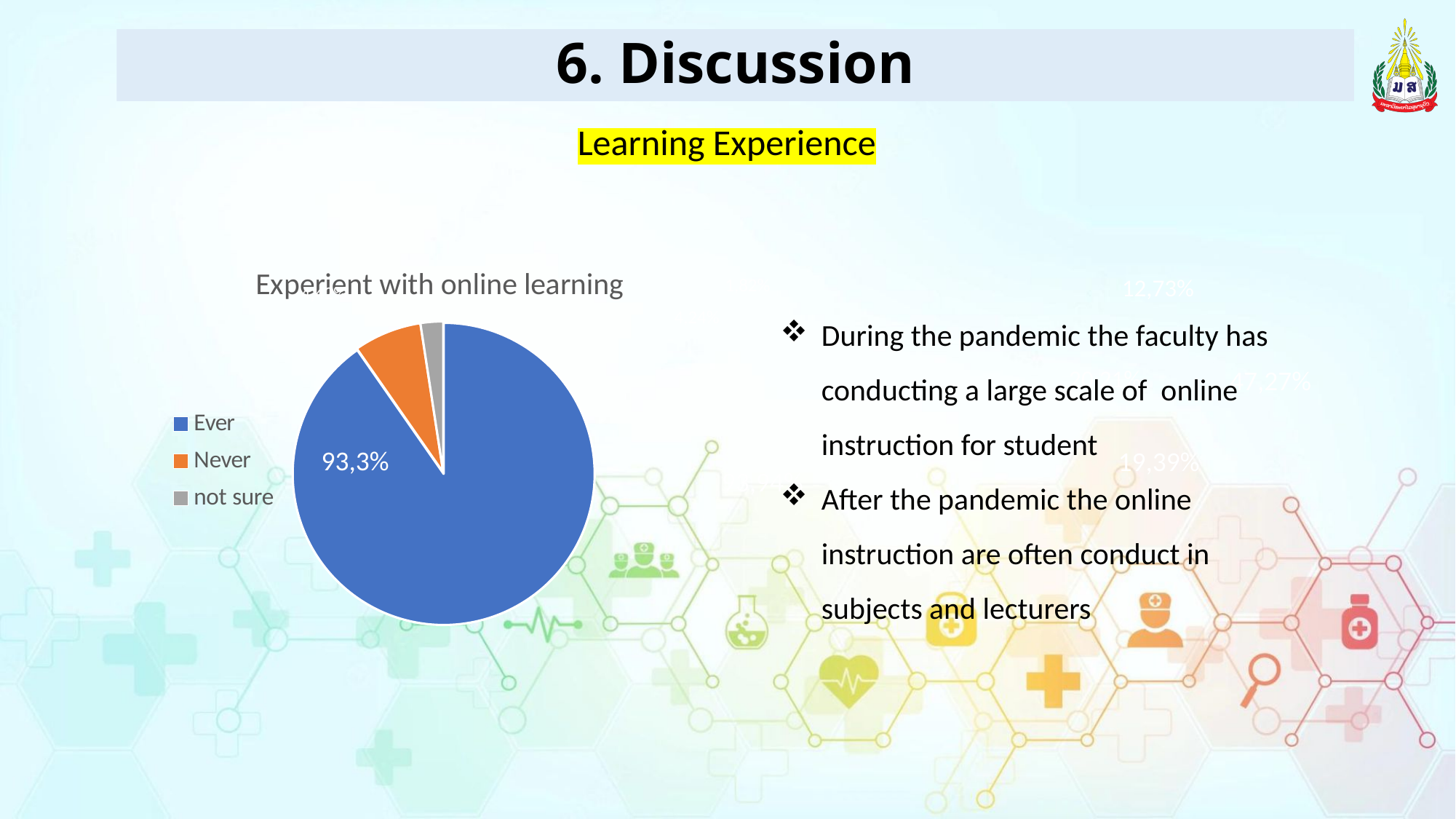
What kind of chart is shown on the slide? pie chart What is the title of the pie chart? Experient with online learning Which category has the smallest slice in the pie chart? not sure Which category has the largest slice in the pie chart? Ever Which slice is larger, "Never" or "not sure"? Never What share of the pie does the "Ever" slice represent? 93,3% Which category is shown in blue in the pie chart? Ever What value is printed on the "Ever" slice of the pie chart? 93,3% What colour is the "Never" slice in the pie chart? orange Which slice is larger, "Ever" or "Never"? Ever How many categories does the pie chart's legend list? 3